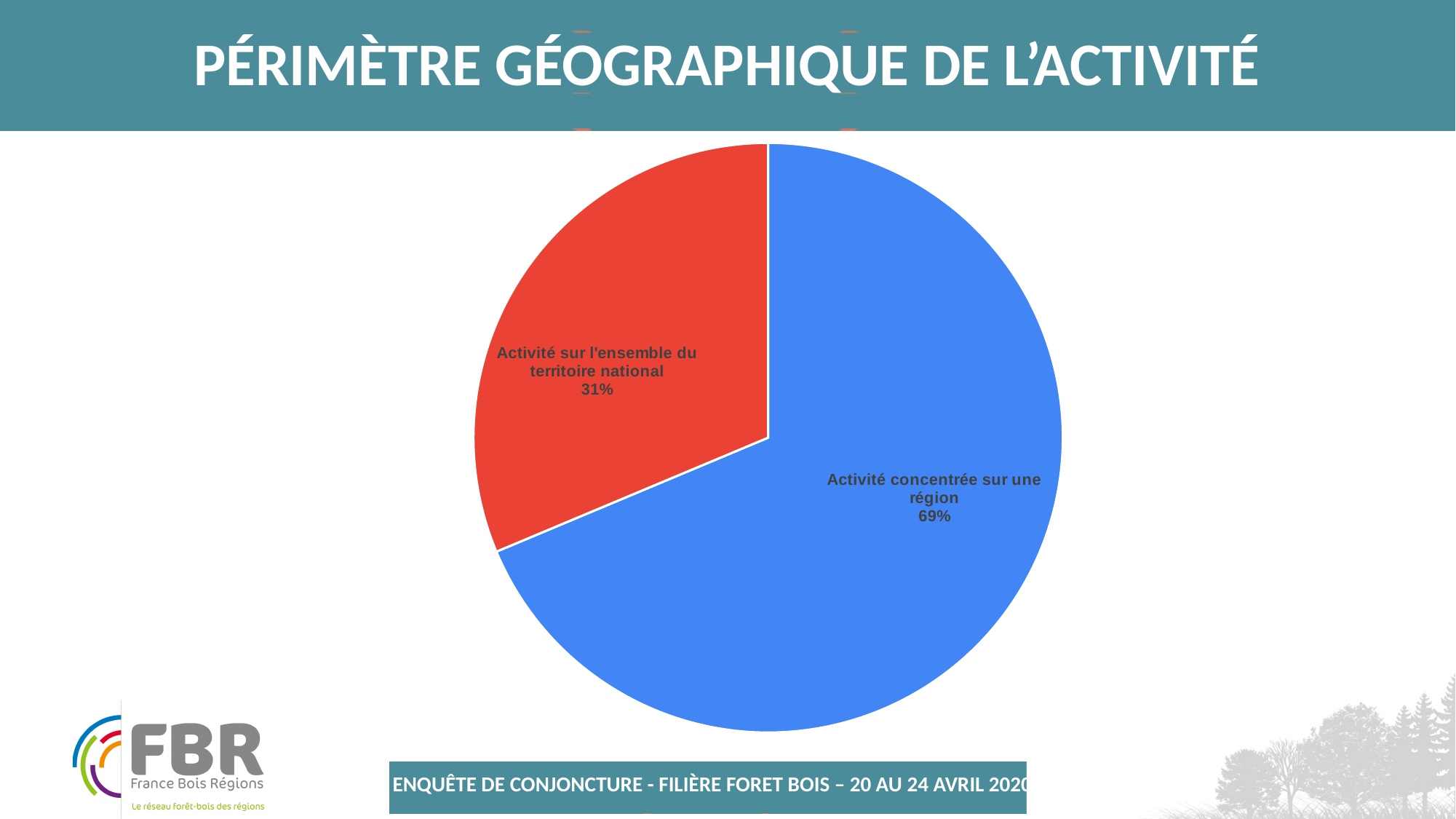
What is the total of the two slices shown in the pie chart? 100% How many slices does the pie chart have? 2 What is the difference in percentage points between 'Activité concentrée sur une région' and 'Activité sur l'ensemble du territoire national'? 38 percentage points Which slice of the pie is the smallest? Activité sur l'ensemble du territoire national What share of the pie is 'Activité sur l'ensemble du territoire national'? 31% What colour is the slice for 'Activité concentrée sur une région'? Blue What kind of chart is shown on the slide? Pie chart Which slice of the pie is the largest? Activité concentrée sur une région Which is larger: the share for 'Activité concentrée sur une région' or for 'Activité sur l'ensemble du territoire national'? Activité concentrée sur une région What share of the pie is 'Activité concentrée sur une région'? 69% What is the title of the slide containing the pie chart? PÉRIMÈTRE GÉOGRAPHIQUE DE L'ACTIVITÉ